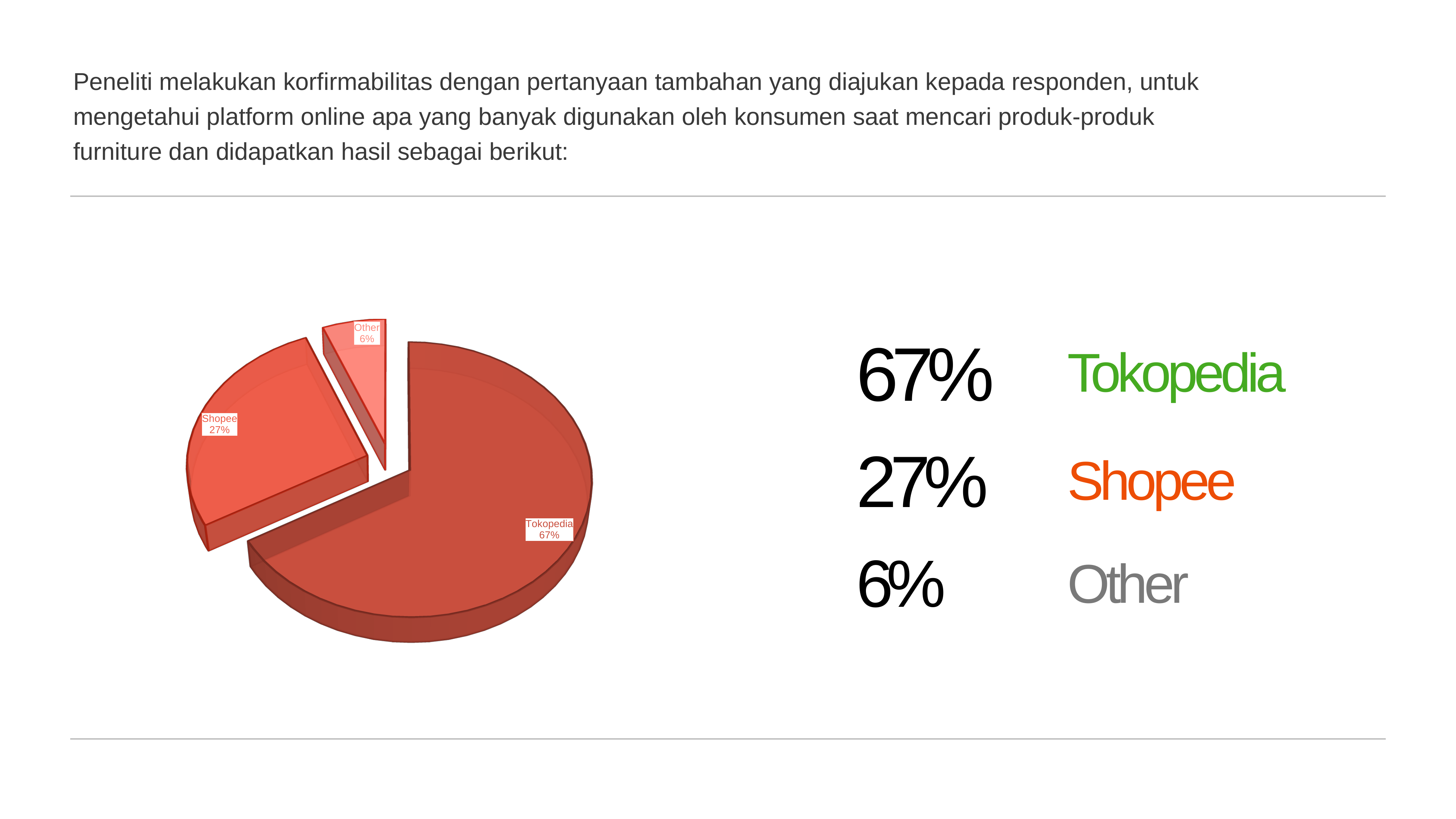
How many slices does the pie chart have? 3 Which slice of the pie is the smallest? Other What is the difference in percentage points between Tokopedia and Shopee? 40 What share of the pie does Tokopedia have? 67% Which slice of the pie is the largest? Tokopedia Which slice of the pie is shown in the lightest shade of red? Other What is the difference in percentage points between Shopee and Other? 21 Is the Tokopedia share greater or less than 50%? greater What share of the pie does Shopee have? 27% Which is larger, the Shopee slice or the Other slice? Shopee What share of the pie does Other have? 6% What kind of chart is shown on the slide? Pie chart